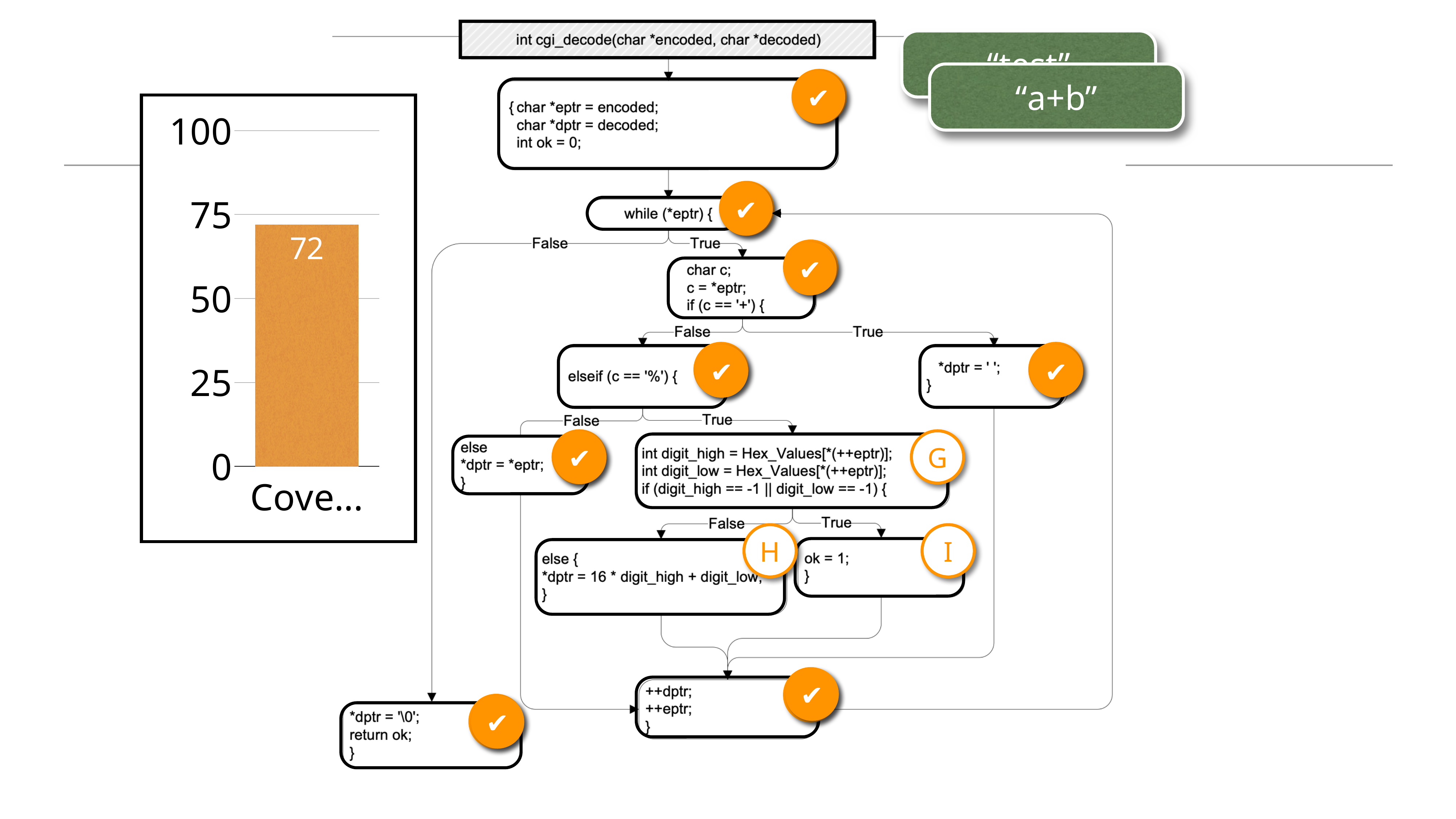
What value is printed on the bar in the bar chart? 72 Is the value of the bar greater or less than 50? greater Is the value of the bar greater or less than 25? greater What kind of chart is shown on the left of the slide? bar chart What colour is the bar in the chart? orange How many bars does the chart contain? 1 Is the value of the bar greater or less than 75? less What is the highest tick value shown on the chart's vertical axis? 100